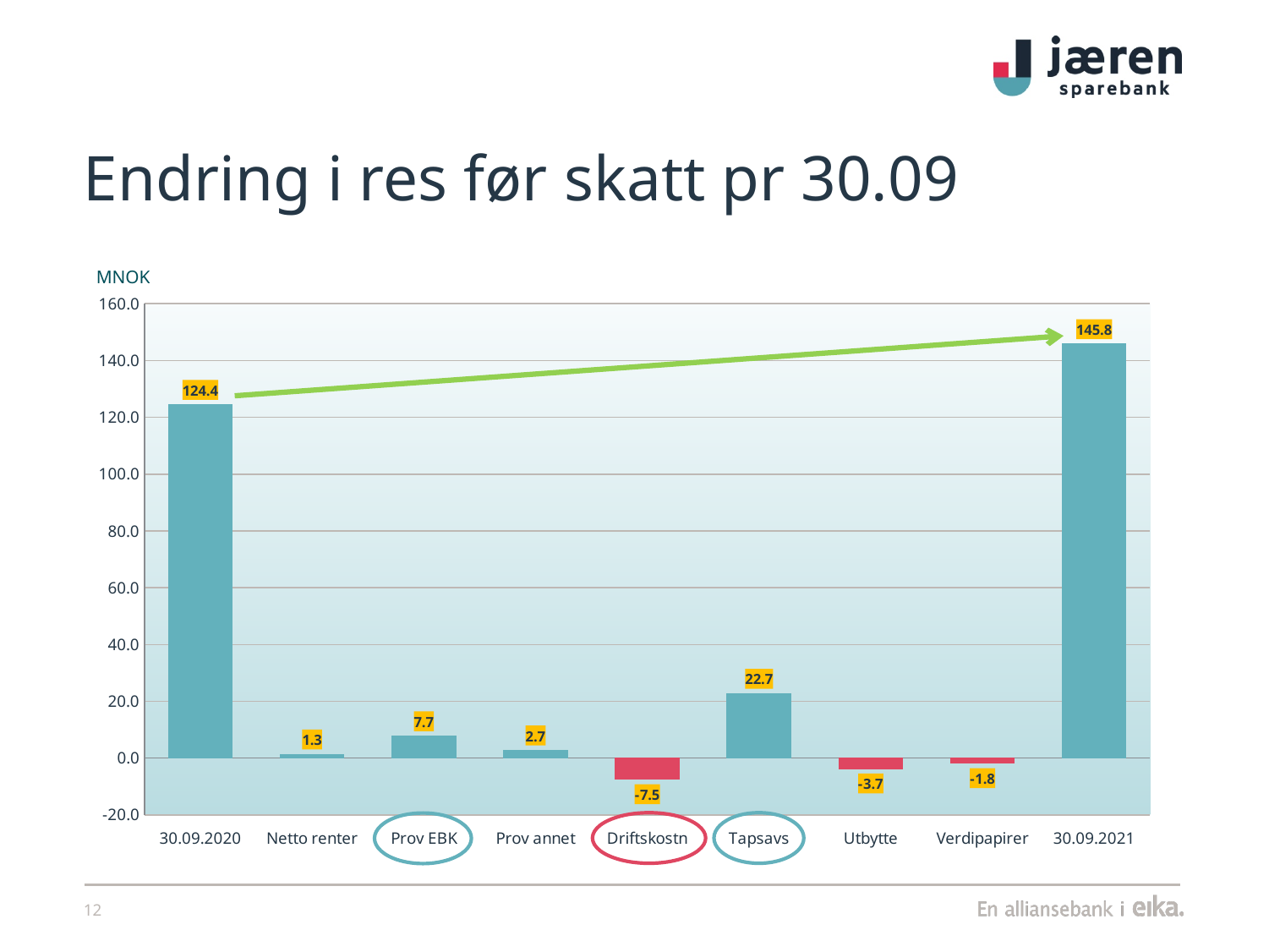
Which category has the highest value? 30.09.2021 What unit is shown above the y axis of the chart? MNOK Which category has the lowest value? Driftskostn How many categories are shown on the x axis? 9 What is the value for Driftskostn? -7.5 What is the value for 30.09.2020? 124.4 What is the value for 30.09.2021? 145.8 What is the value for Prov EBK? 7.7 Which is larger, the value for Netto renter or the value for Prov annet? Prov annet What is the difference between the values for 30.09.2021 and 30.09.2020? 21.4 What is the value for Tapsavs? 22.7 What kind of chart is shown on the slide? bar chart